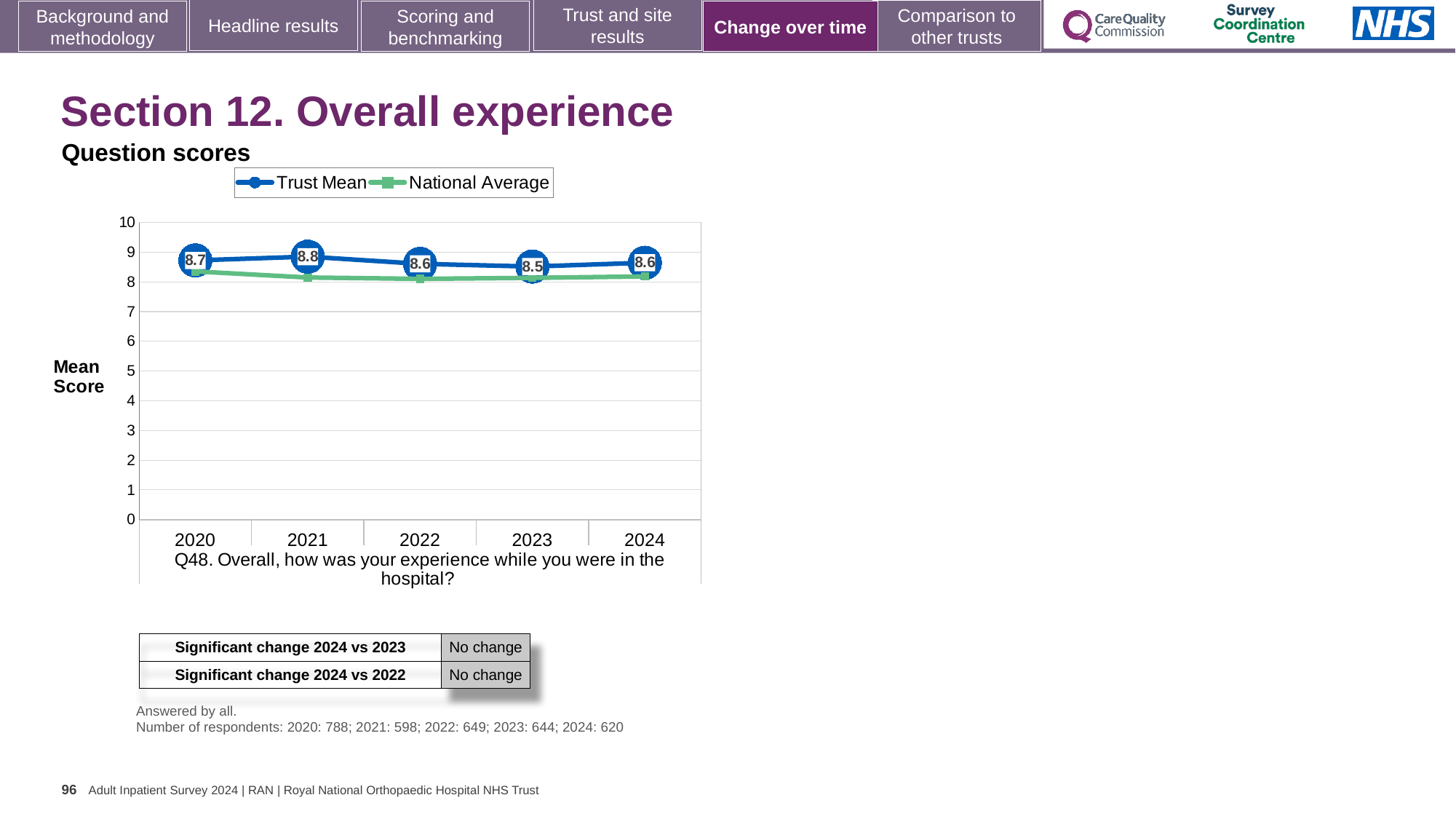
What is the Trust Mean score for 2020? 8.7 How many series does the legend list? 2 In which year is the Trust Mean score lowest? 2023 How many years are shown on the x axis? 5 What is the difference between the Trust Mean scores for 2021 and 2023? 0.3 Which is larger, the Trust Mean score for 2020 or for 2024? 2020 Which series is drawn in green? National Average In which year is the Trust Mean score highest? 2021 Is the National Average value for 2022 greater or less than 9? less What is the Trust Mean score for 2021? 8.8 What is the Trust Mean score for 2023? 8.5 What kind of chart is shown on the slide? Line chart